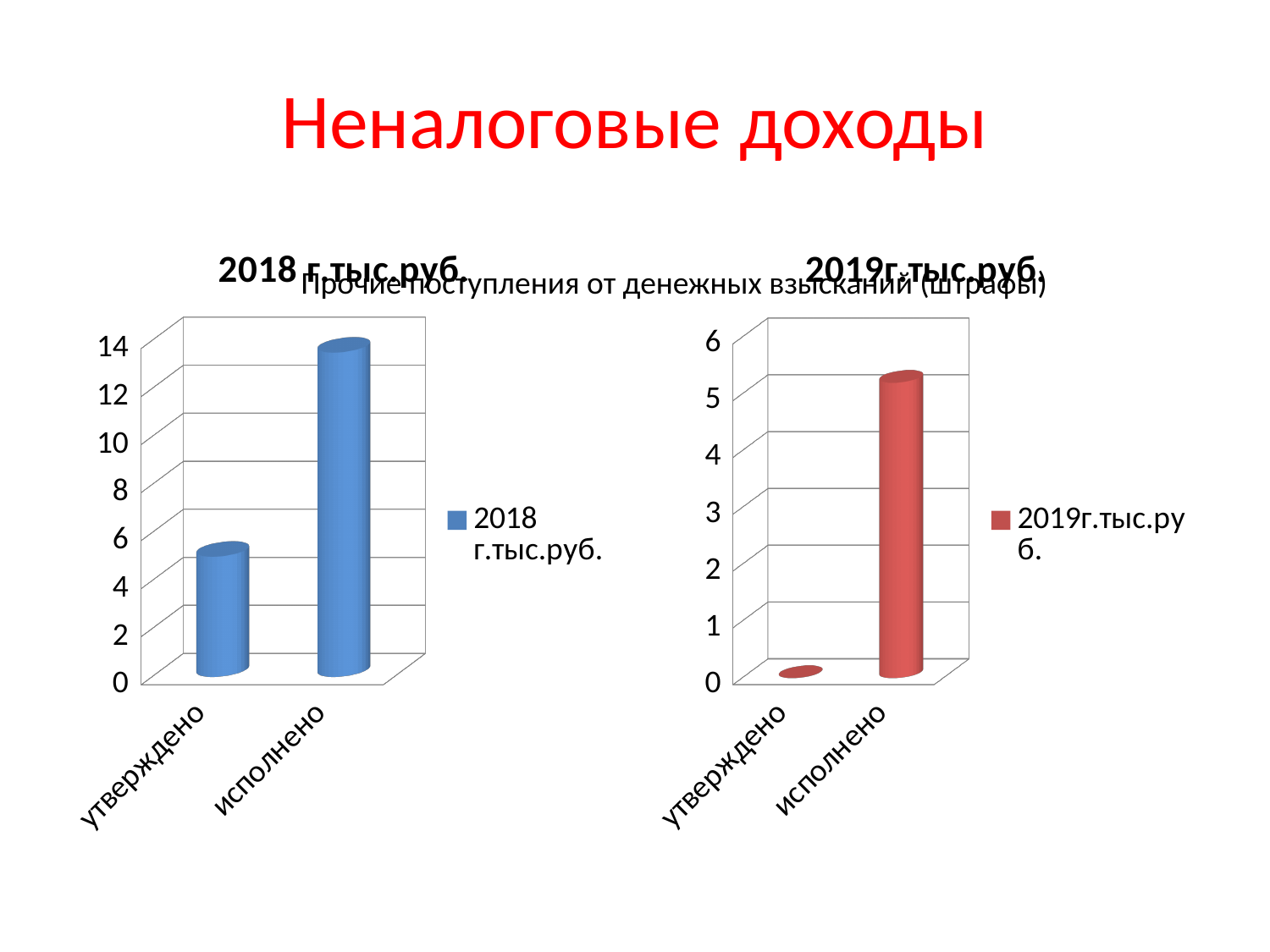
In the left chart (2018 г.тыс.руб.), which category has the highest value? исполнено In the right chart (2019г.тыс.руб.), which category has the highest value? исполнено In the left chart (2018 г.тыс.руб.), which category has the lowest value? утверждено In the right chart (2019г.тыс.руб.), is the value for исполнено greater or less than 4? greater How many categories are shown on the x axis of the left chart (2018 г.тыс.руб.)? 2 In the left chart (2018 г.тыс.руб.), is the value for исполнено greater or less than 12? greater What colour are the bars in the right chart (2019г.тыс.руб.)? red In the right chart (2019г.тыс.руб.), which is larger, утверждено or исполнено? исполнено How many series does the legend of the right chart (2019г.тыс.руб.) list? 1 What kind of chart is the left chart titled "2018 г.тыс.руб."? bar chart In the left chart (2018 г.тыс.руб.), is the value for утверждено greater or less than 6? less